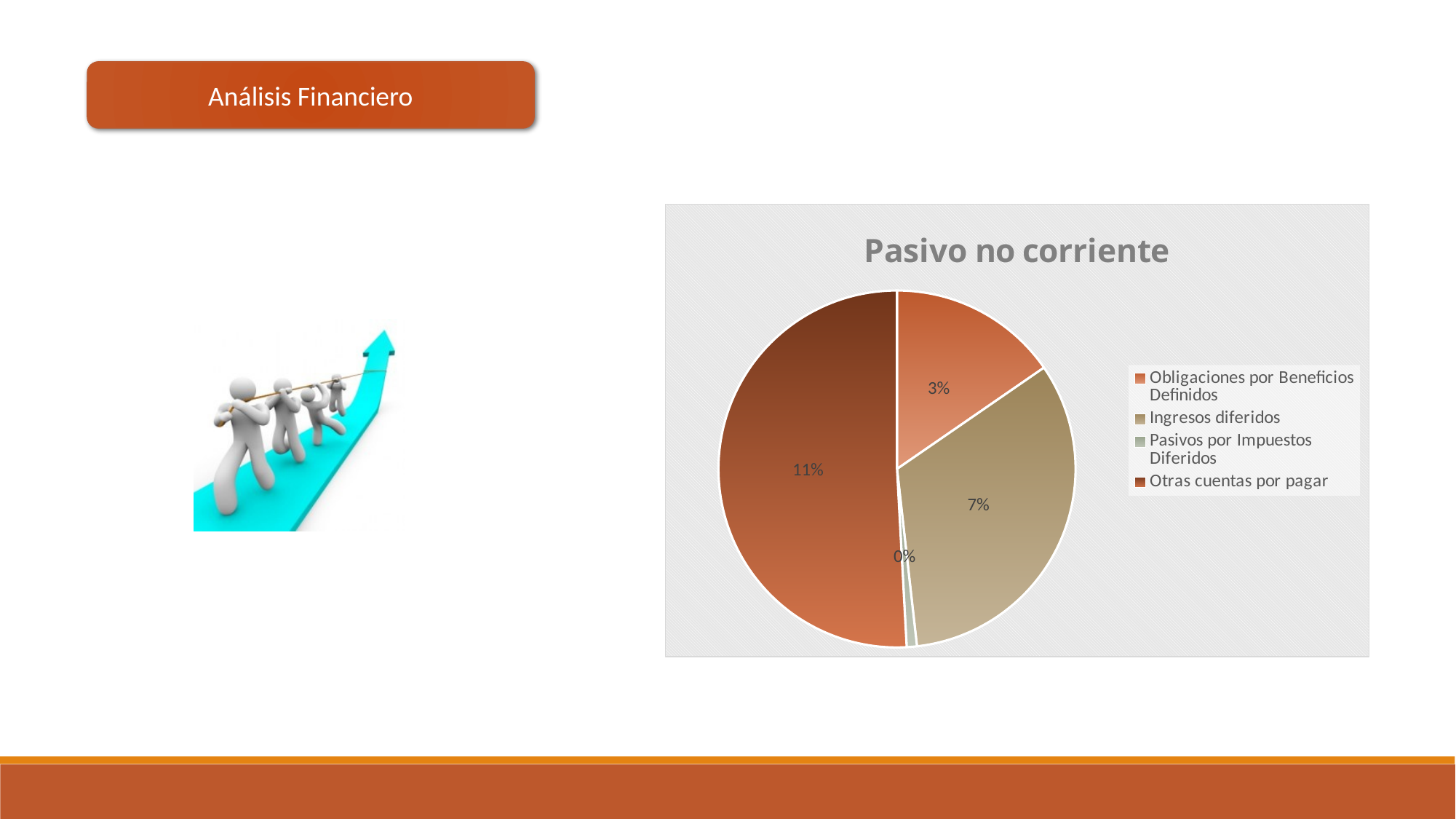
What value is labelled on the slice for Pasivos por Impuestos Diferidos? 0% Which slice is larger, Ingresos diferidos or Obligaciones por Beneficios Definidos? Ingresos diferidos What value is labelled on the slice for Otras cuentas por pagar? 11% What value is labelled on the slice for Ingresos diferidos? 7% What kind of chart is shown on the slide? Pie chart Which category has the largest slice of the pie? Otras cuentas por pagar What is the difference between the labelled values for Otras cuentas por pagar and Obligaciones por Beneficios Definidos? 8% Which category has the smallest slice of the pie? Pasivos por Impuestos Diferidos What is the title of the chart? Pasivo no corriente What value is labelled on the slice for Obligaciones por Beneficios Definidos? 3% How many slices does the pie chart have? 4 How many entries does the legend list? 4